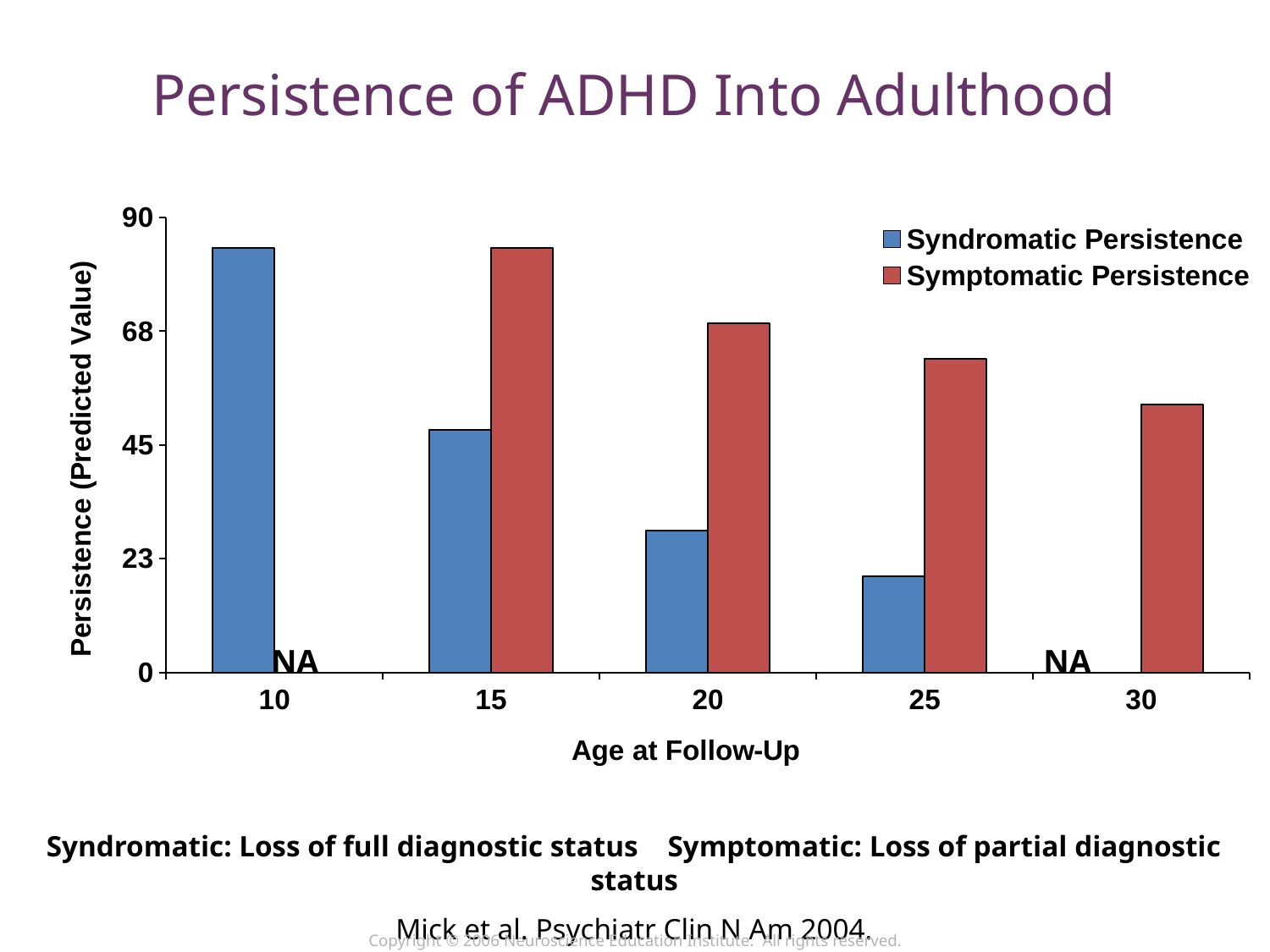
At which age at follow-up is Syndromatic Persistence highest? 10 Does Syndromatic Persistence rise or fall as age at follow-up increases from 10 to 25? fall What kind of chart is shown on the slide? bar chart How many series does the legend list? 2 Is the Syndromatic Persistence value at age 10 greater or less than 68? greater How many age categories are shown on the x axis? 5 Is the Symptomatic Persistence value at age 30 greater or less than 45? greater At age 20, which is larger: Syndromatic Persistence or Symptomatic Persistence? Symptomatic Persistence Among the ages where it is plotted, at which age is Symptomatic Persistence lowest? 30 Among the ages where it is plotted, at which age is Syndromatic Persistence lowest? 25 Is the Syndromatic Persistence value at age 25 greater or less than 23? less At which age at follow-up is Symptomatic Persistence highest? 15